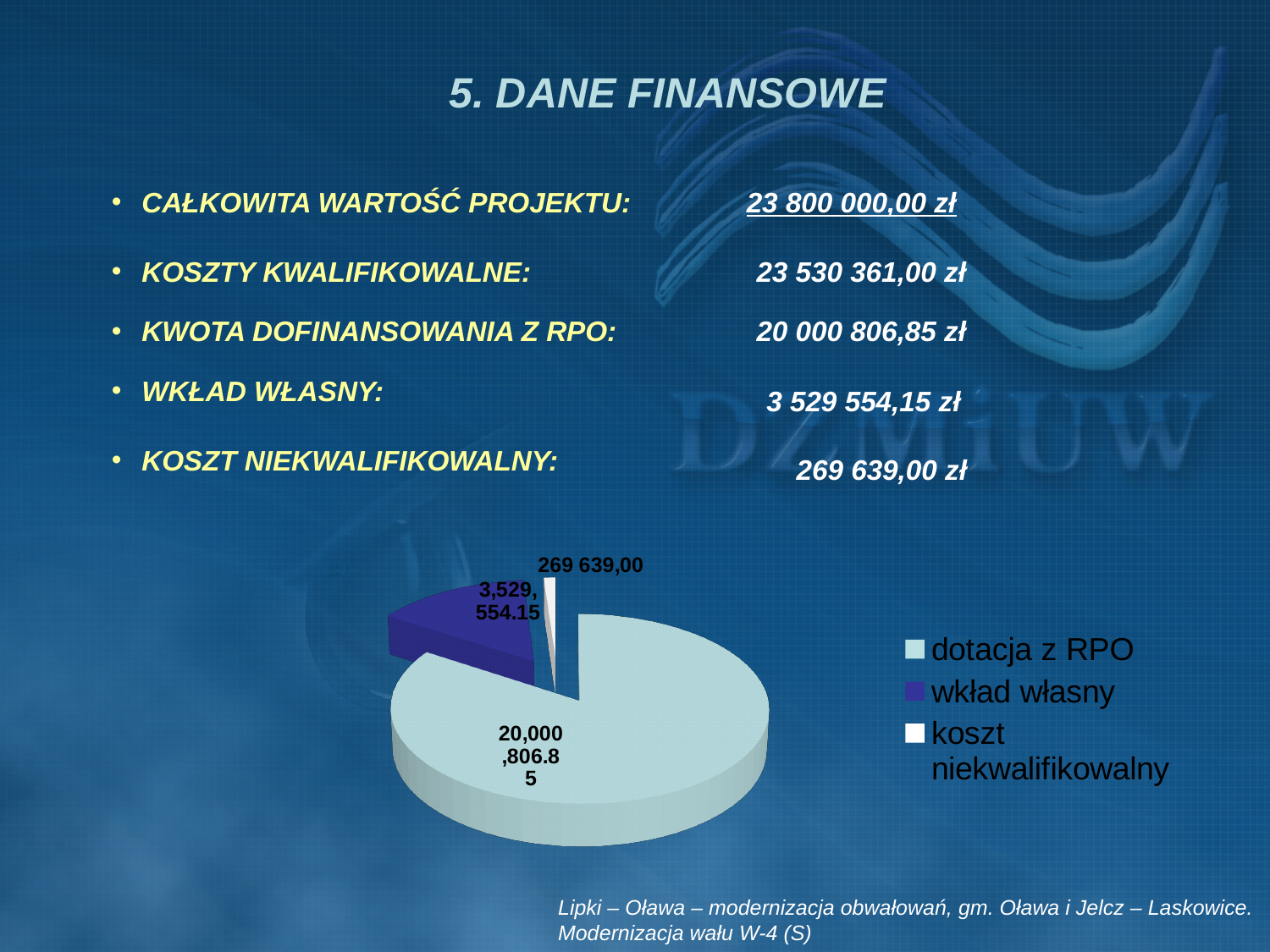
What value is shown for the 'wkład własny' slice of the pie chart? 3,529,554.15 What value is shown for the 'dotacja z RPO' slice of the pie chart? 20,000,806.85 Which is larger in the pie chart: 'wkład własny' or 'koszt niekwalifikowalny'? wkład własny How many slices does the pie chart have? 3 How many entries does the legend of the pie chart list? 3 Which slice of the pie chart is the smallest? koszt niekwalifikowalny What is the total of all three slices in the pie chart? 23,800,000.00 What is the difference between the 'dotacja z RPO' and 'wkład własny' values in the pie chart? 16,471,252.70 Which slice of the pie chart is the largest? dotacja z RPO What type of chart is shown on the slide? pie chart Which legend entry of the pie chart is shown in dark blue? wkład własny What value is shown for the 'koszt niekwalifikowalny' slice of the pie chart? 269 639,00